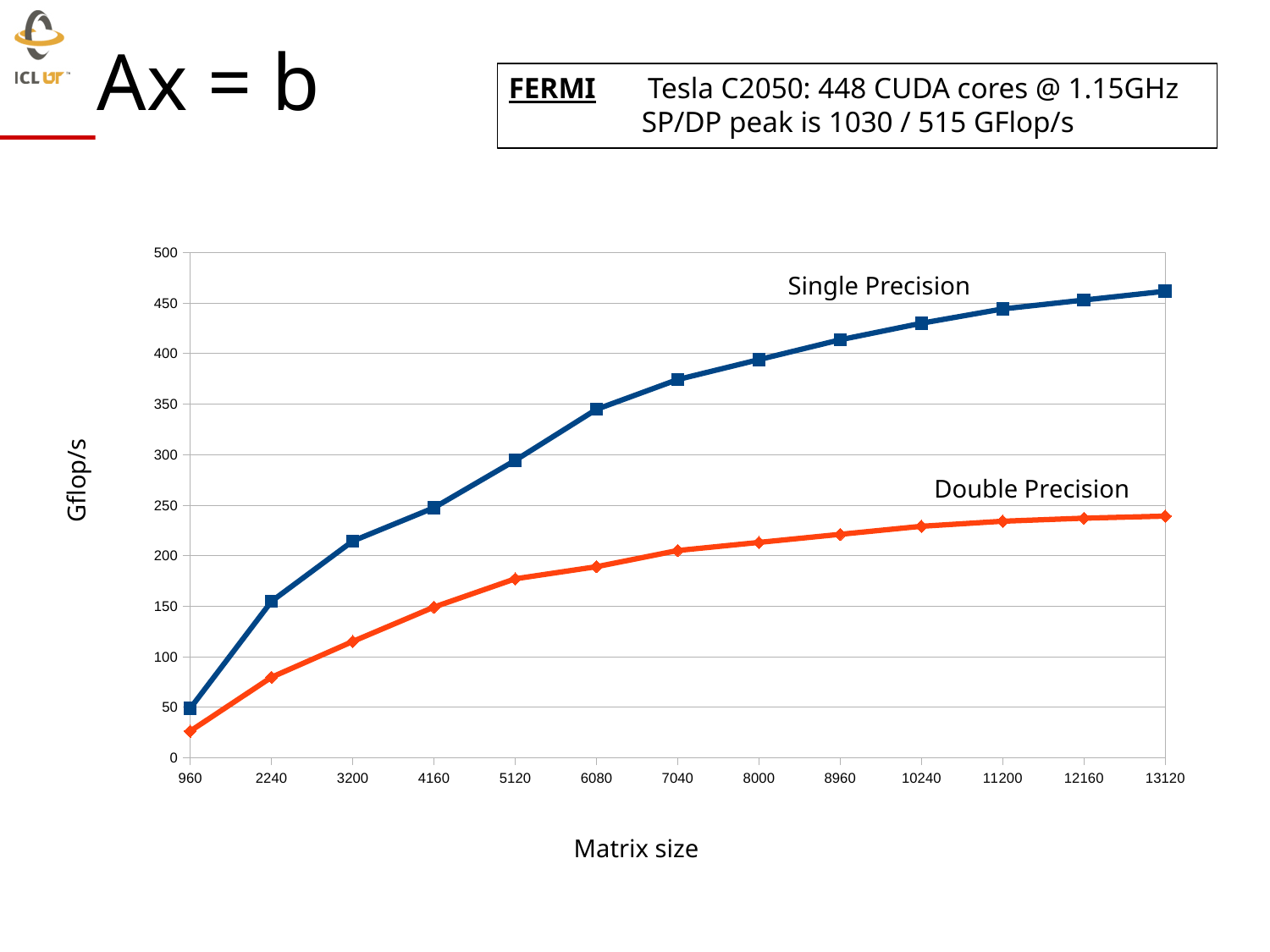
How many series are plotted on the chart? 2 Does the Single Precision series rise or fall as matrix size increases? rises How many matrix sizes are plotted along the x axis? 13 At which matrix size does the Double Precision series reach its highest value? 13120 What is the label on the y axis of the chart? Gflop/s What kind of chart is shown on the slide? line chart At which matrix size is the Single Precision value lowest? 960 Is the Single Precision value at matrix size 13120 greater or less than 400? greater Is the Single Precision value at matrix size 6080 greater or less than 300? greater Is the Double Precision value at matrix size 960 greater or less than 50? less Which series has the higher value at matrix size 8000, Single Precision or Double Precision? Single Precision